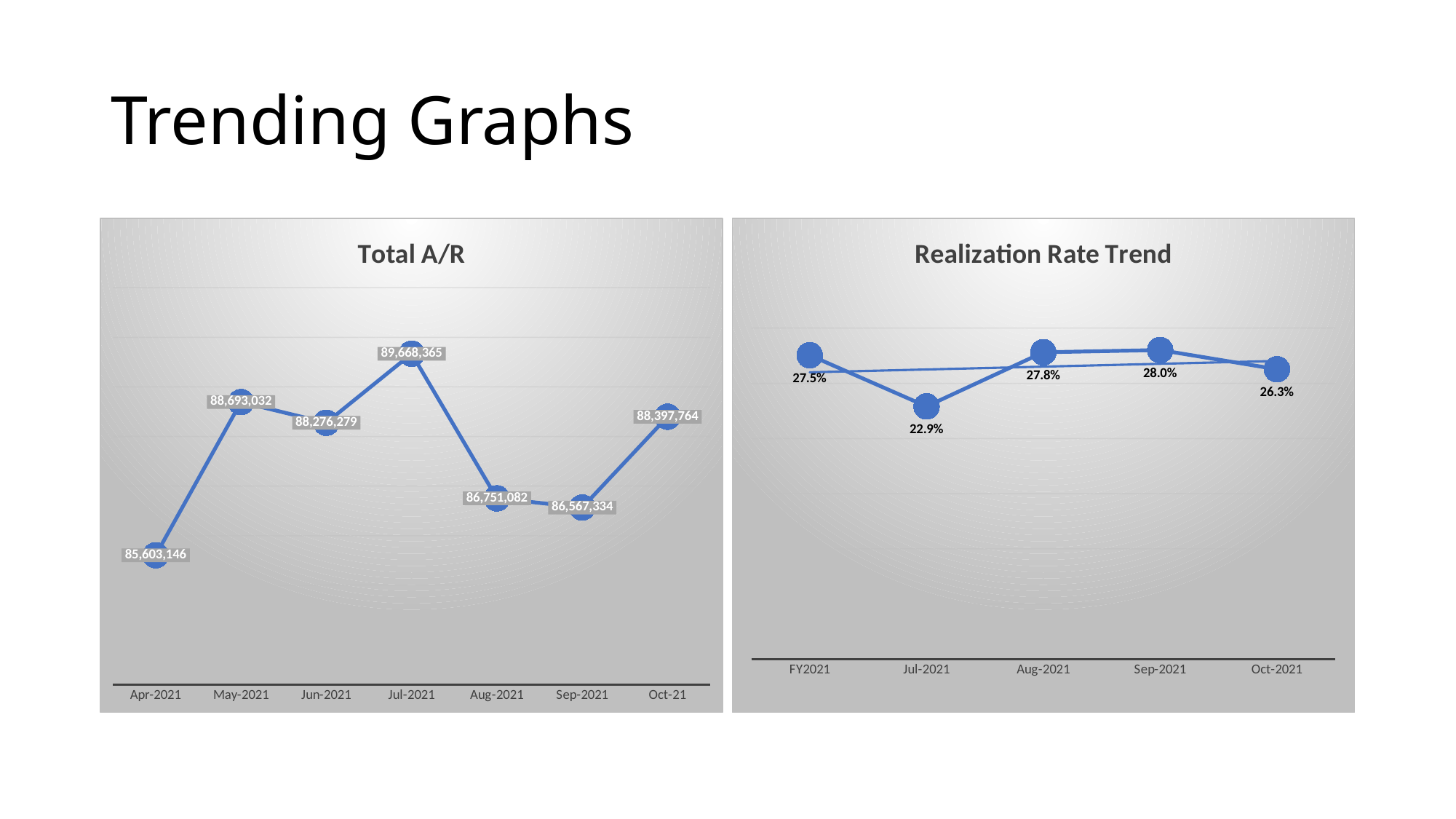
In the Realization Rate Trend chart, what is the difference between the Sep-2021 and Oct-2021 values? 1.7% How many data points are plotted in the Realization Rate Trend chart? 5 In the Realization Rate Trend chart, which period has the highest value? Sep-2021 What kind of chart is the Total A/R chart? Line chart In the Total A/R chart, which is larger, the value for May-2021 or the value for Oct-21? May-2021 In the Total A/R chart, what is the value for Apr-2021? 85,603,146 In the Total A/R chart, what is the value for Jul-2021? 89,668,365 In the Total A/R chart, what is the difference between the Jul-2021 and Aug-2021 values? 2,917,283 How many data points are plotted in the Total A/R chart? 7 In the Total A/R chart, which month has the lowest value? Apr-2021 In the Total A/R chart, which month has the highest value? Jul-2021 In the Realization Rate Trend chart, what is the value for Jul-2021? 22.9%